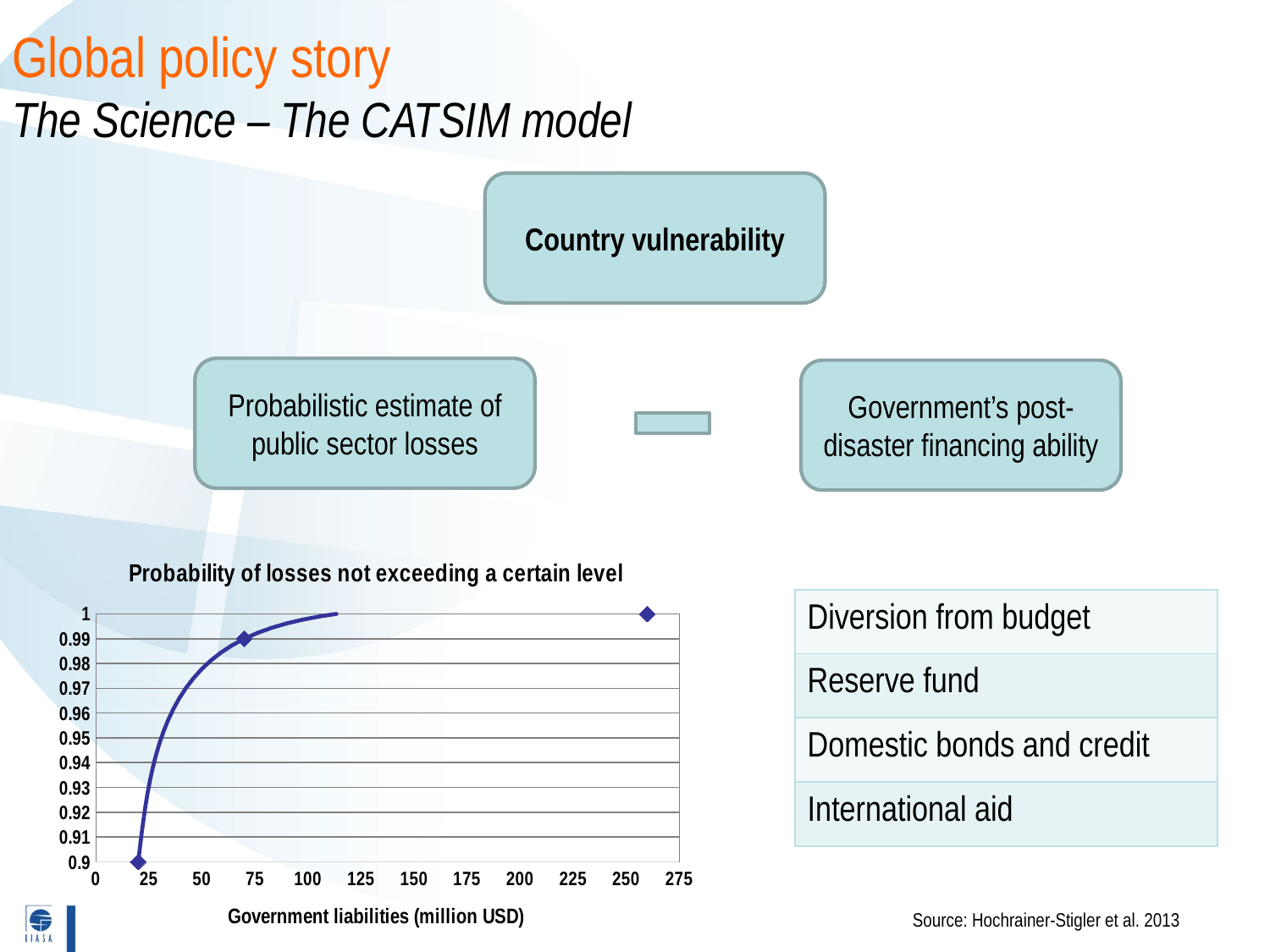
Is the probability at 50 million USD greater or less than 0.95? greater How many diamond markers are plotted on the chart? 3 Is the probability at 75 million USD greater or less than 0.9? greater What kind of chart is shown on the slide? line chart What is the title of the chart? Probability of losses not exceeding a certain level Is the government liabilities value of the leftmost diamond marker greater or less than 25? less Which is larger, the probability at 25 million USD or at 75 million USD? 75 million USD What is the label of the x axis of the chart? Government liabilities (million USD) Does the probability rise or fall as government liabilities increase along the x axis? rise